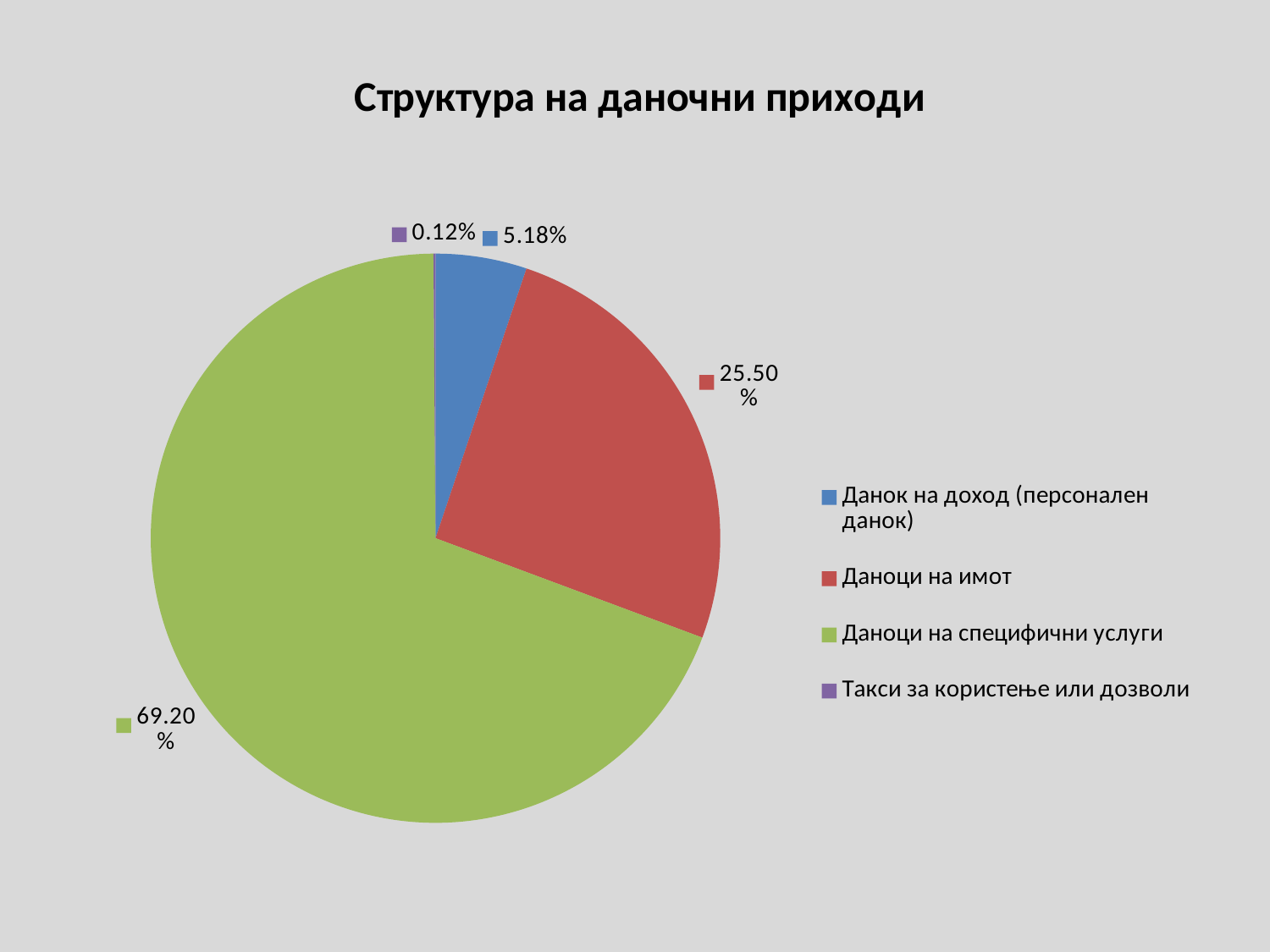
Which category has the largest slice of the pie? Даноци на специфични услуги Which category has the smallest slice of the pie? Такси за користење или дозволи What kind of chart is shown on the slide? pie chart What share of the pie does Даноци на имот have? 25.50% How many categories does the legend list? 4 What share of the pie does Данок на доход (персонален данок) have? 5.18% Which is larger, the share of Даноци на имот or the share of Данок на доход (персонален данок)? Даноци на имот What share of the pie does Такси за користење или дозволи have? 0.12% What share of the pie does Даноци на специфични услуги have? 69.20% What is the difference between the shares of Даноци на специфични услуги and Даноци на имот? 43.70% What colour is the slice for Даноци на имот? red What is the title of the chart? Структура на даночни приходи